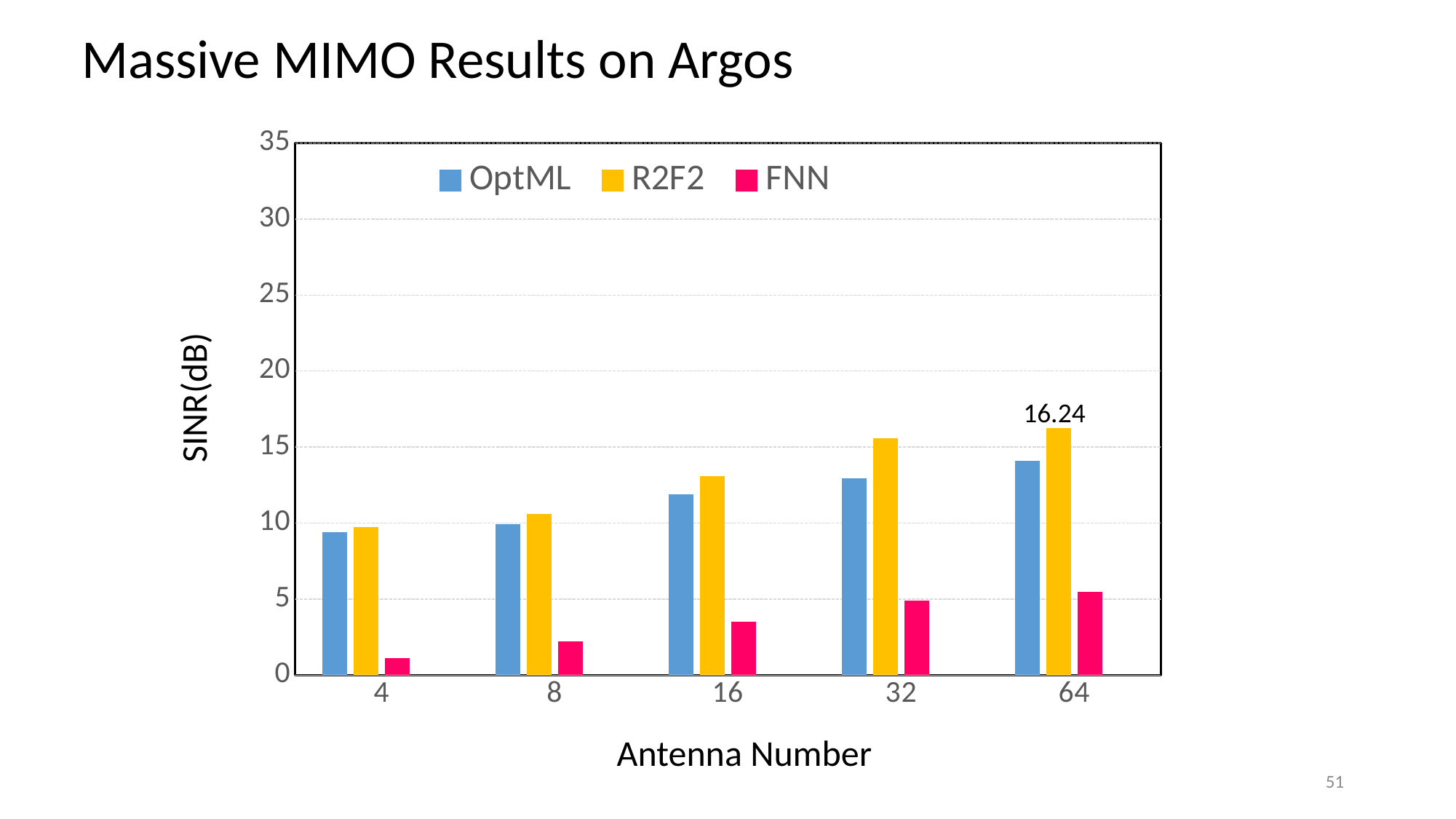
At which antenna number is the FNN value lowest? 4 What kind of chart is shown on the slide? bar chart How many series does the legend list? 3 How many antenna number categories are shown on the x axis? 5 Is the value for OptML at antenna number 64 greater or less than 10? greater What is the label of the y axis? SINR(dB) What is the label of the x axis? Antenna Number At antenna number 32, which is larger: OptML or R2F2? R2F2 Do the FNN values rise or fall as the antenna number increases? rise Is the value for FNN at antenna number 16 greater or less than 5? less What is the SINR(dB) value for R2F2 at antenna number 64? 16.24 At which antenna number is the R2F2 value highest? 64